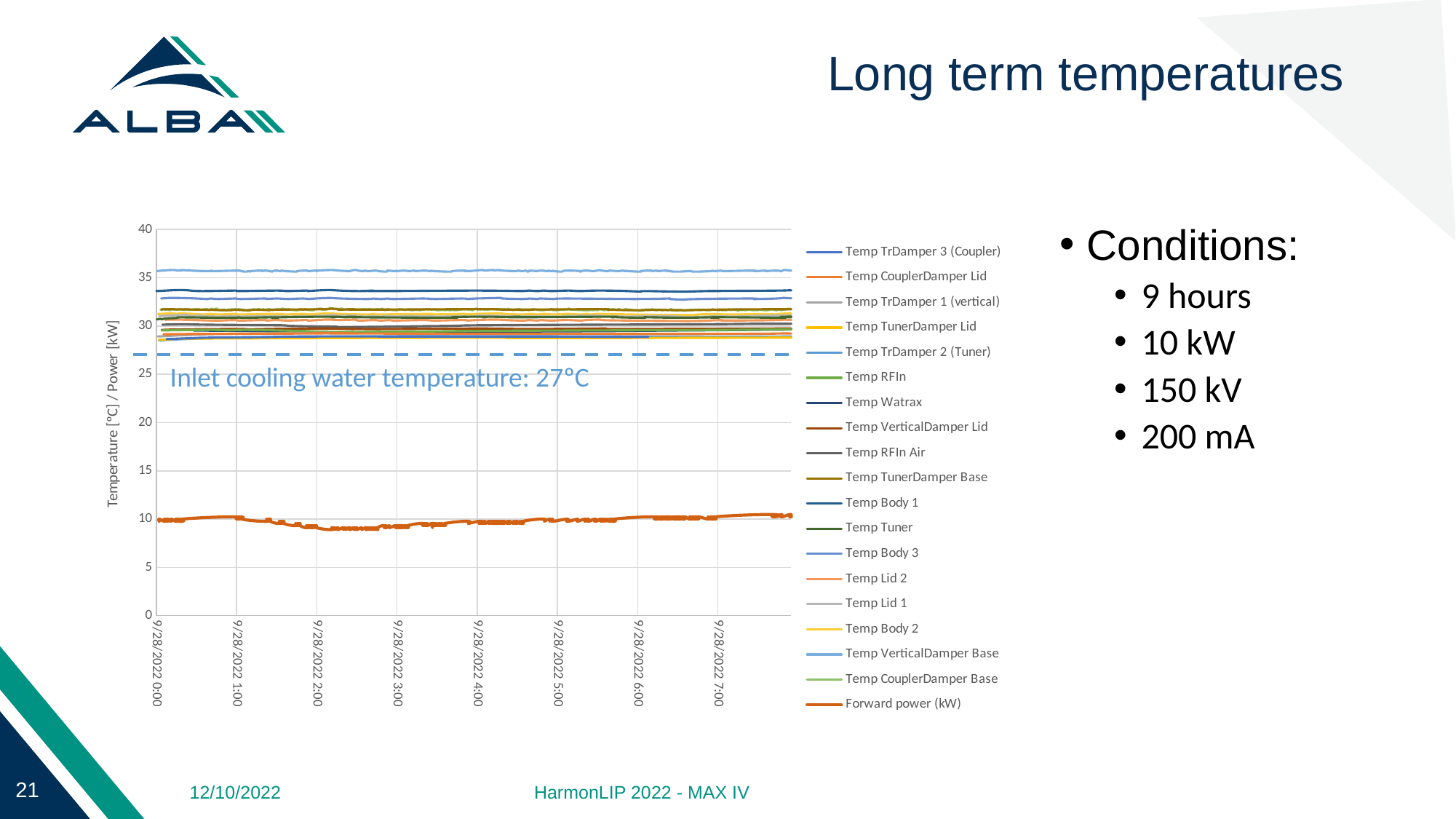
Is the value of Forward power (kW) greater or less than 5? greater How many series does the chart legend list? 19 Is the inlet cooling water temperature shown by the dashed line greater or less than 30? less What is the label of the y axis? Temperature [°C] / Power [kW] Is the value of Forward power (kW) greater or less than 15? less What kind of chart is shown on the slide? line chart Do the temperature series rise, fall, or stay roughly flat over the time shown? roughly flat How many time labels are shown on the x axis? 8 Which series has the lowest values on the chart? Forward power (kW) What is the first time label on the x axis? 9/28/2022 0:00 What inlet cooling water temperature is annotated on the chart? 27°C